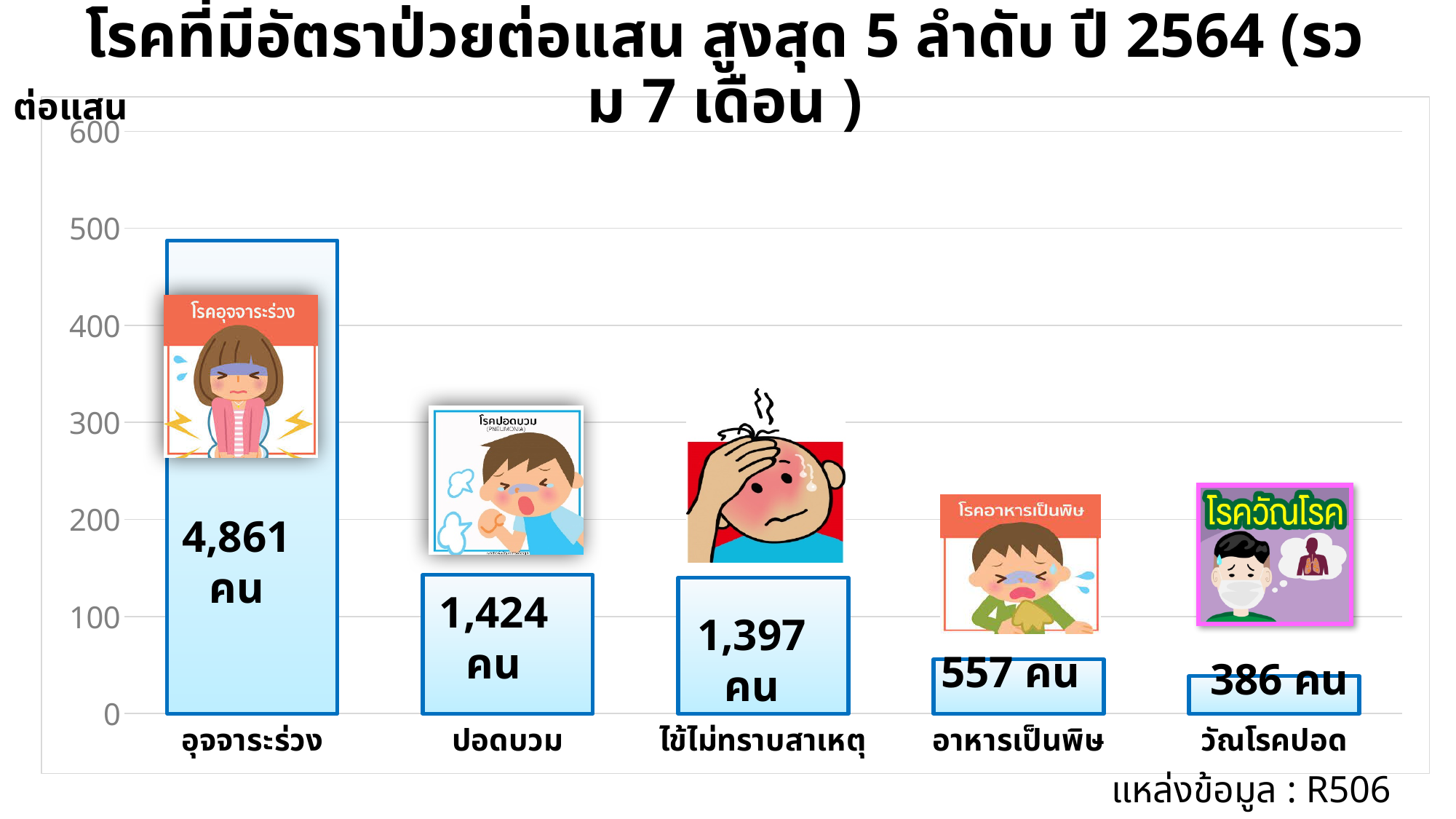
On the y axis, is the bar for อุจจาระร่วง greater or less than 400? greater What value is printed on the bar for วัณโรคปอด? 386 คน How many diseases (categories) are shown in the chart? 5 Based on the printed labels, which is larger: ปอดบวม or ไข้ไม่ทราบสาเหตุ? ปอดบวม What value is printed on the bar for อุจจาระร่วง? 4,861 คน What value is printed on the bar for ปอดบวม? 1,424 คน What kind of chart is shown on the slide? bar chart What is the difference between the printed values for อุจจาระร่วง (4,861) and ปอดบวม (1,424)? 3,437 On the y axis, is the bar for อาหารเป็นพิษ greater or less than 100? less What is the difference between the printed values for อาหารเป็นพิษ (557) and วัณโรคปอด (386)? 171 Which disease has the lowest bar in the chart? วัณโรคปอด Which disease has the highest bar in the chart? อุจจาระร่วง